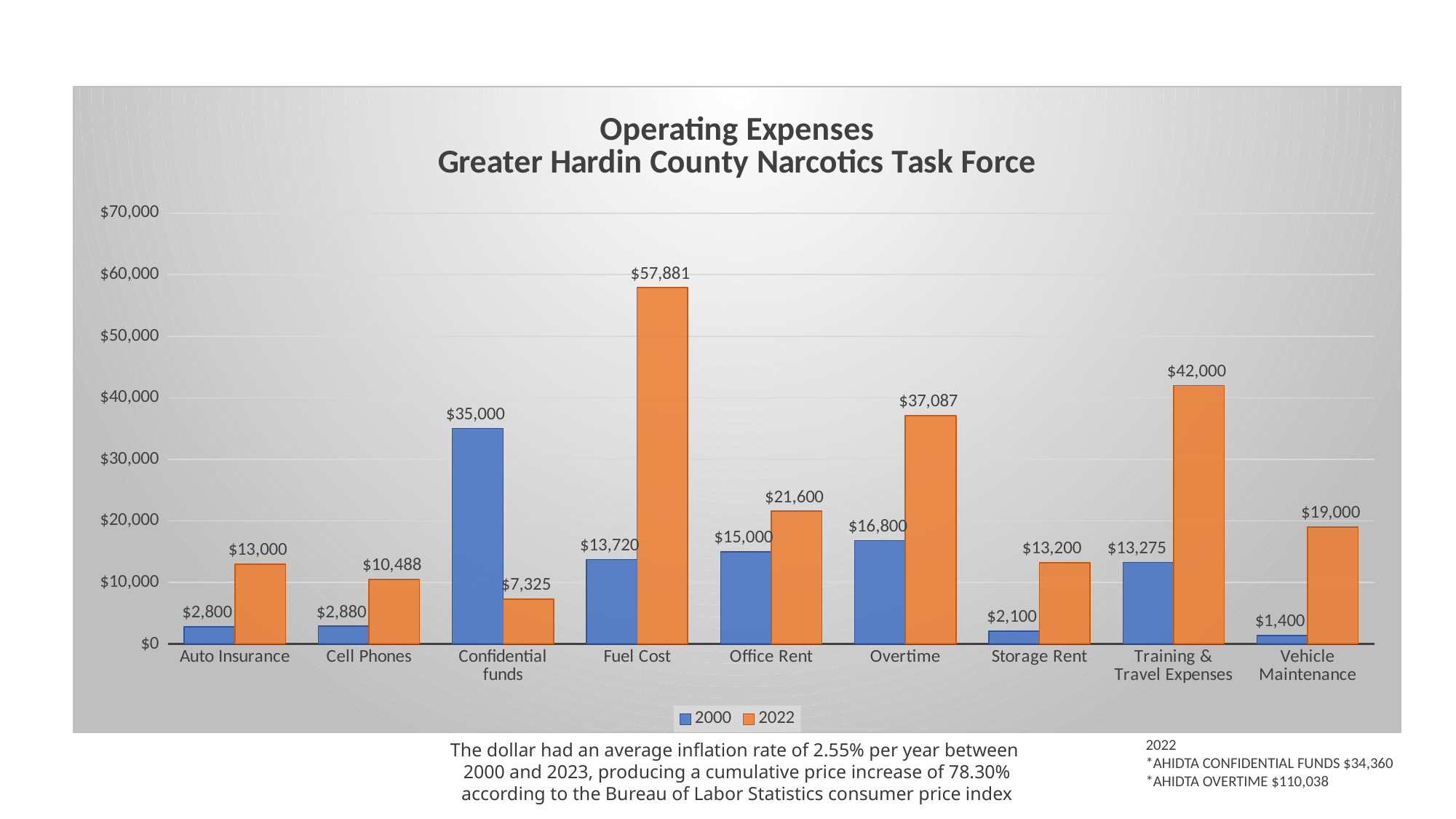
Is the 2022 value for Office Rent greater or less than $20,000? greater What is the difference between the 2022 and 2000 values for Overtime? $20,287 Which category has the lowest 2000 value? Vehicle Maintenance What is the 2022 value for Fuel Cost? $57,881 How many series does the legend list? 2 What is the 2000 value for Confidential funds? $35,000 What is the 2022 value for Training & Travel Expenses? $42,000 Which is larger for Confidential funds, the 2000 value or the 2022 value? 2000 What kind of chart is shown? Bar chart Which colour represents the 2022 series? Orange How many expense categories are shown on the x axis? 9 Which category has the highest 2022 value? Fuel Cost